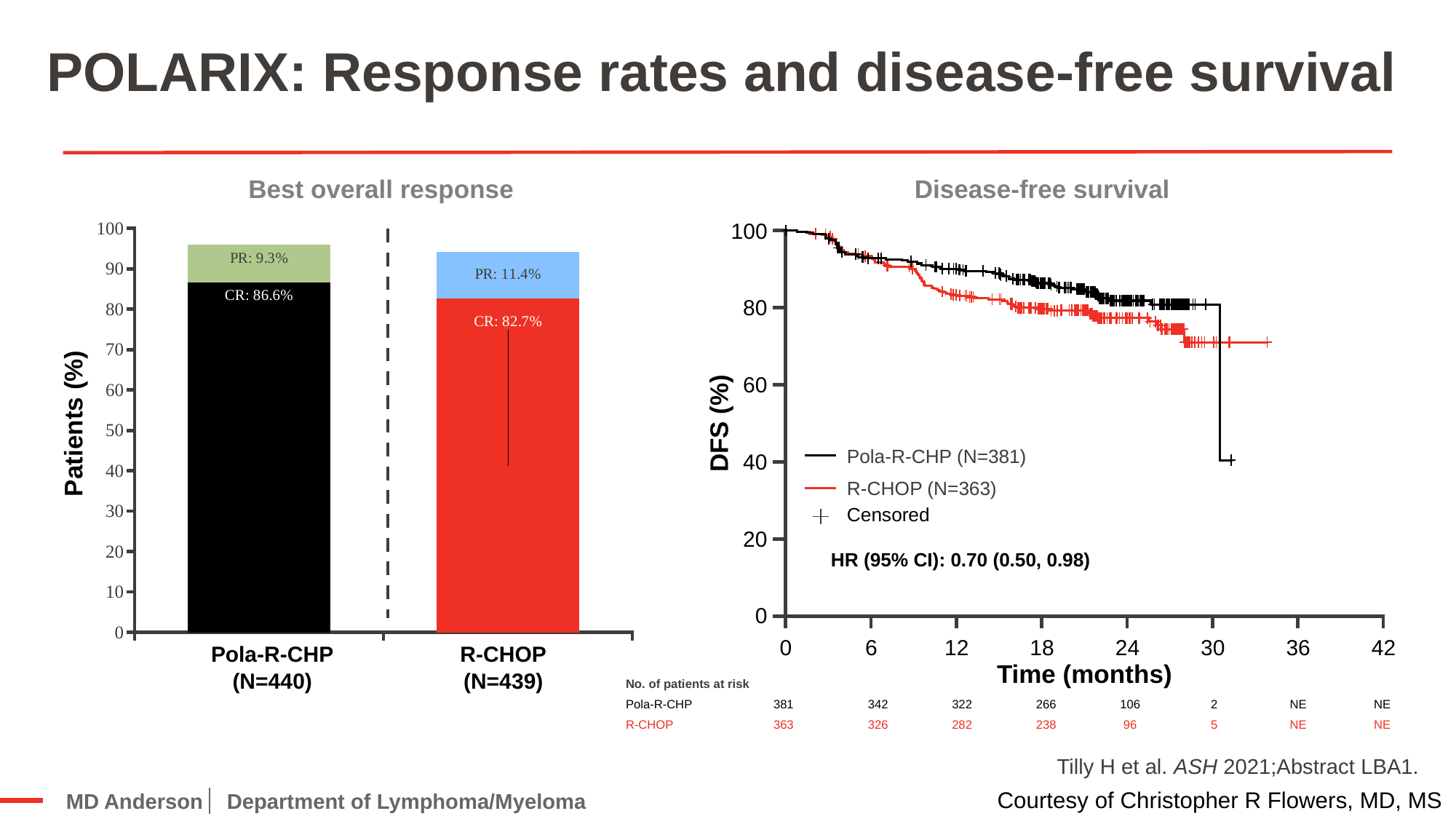
How many treatment arms are shown in the Best overall response chart? 2 In the Disease-free survival chart, is the Pola-R-CHP DFS at 24 months greater or less than 60%? greater In the Disease-free survival chart, how many R-CHOP patients were at risk at 18 months? 238 In the Best overall response chart, what is the CR rate for Pola-R-CHP? 86.6% In the Best overall response chart, which arm has the larger PR rate, Pola-R-CHP or R-CHOP? R-CHOP In the Disease-free survival chart, what is the hazard ratio with 95% CI shown? 0.70 (0.50, 0.98) In the Disease-free survival chart, do the DFS curves rise or fall as time increases? Fall In the Best overall response chart, what is the difference between the CR rates of Pola-R-CHP and R-CHOP? 3.9% In the Disease-free survival chart, how many treatment groups does the legend list? 2 In the Best overall response chart, what is the PR rate for R-CHOP? 11.4% What kind of chart is the Best overall response chart? Bar chart In the Best overall response chart, what is the total (CR plus PR) of the Pola-R-CHP bar? 95.9%